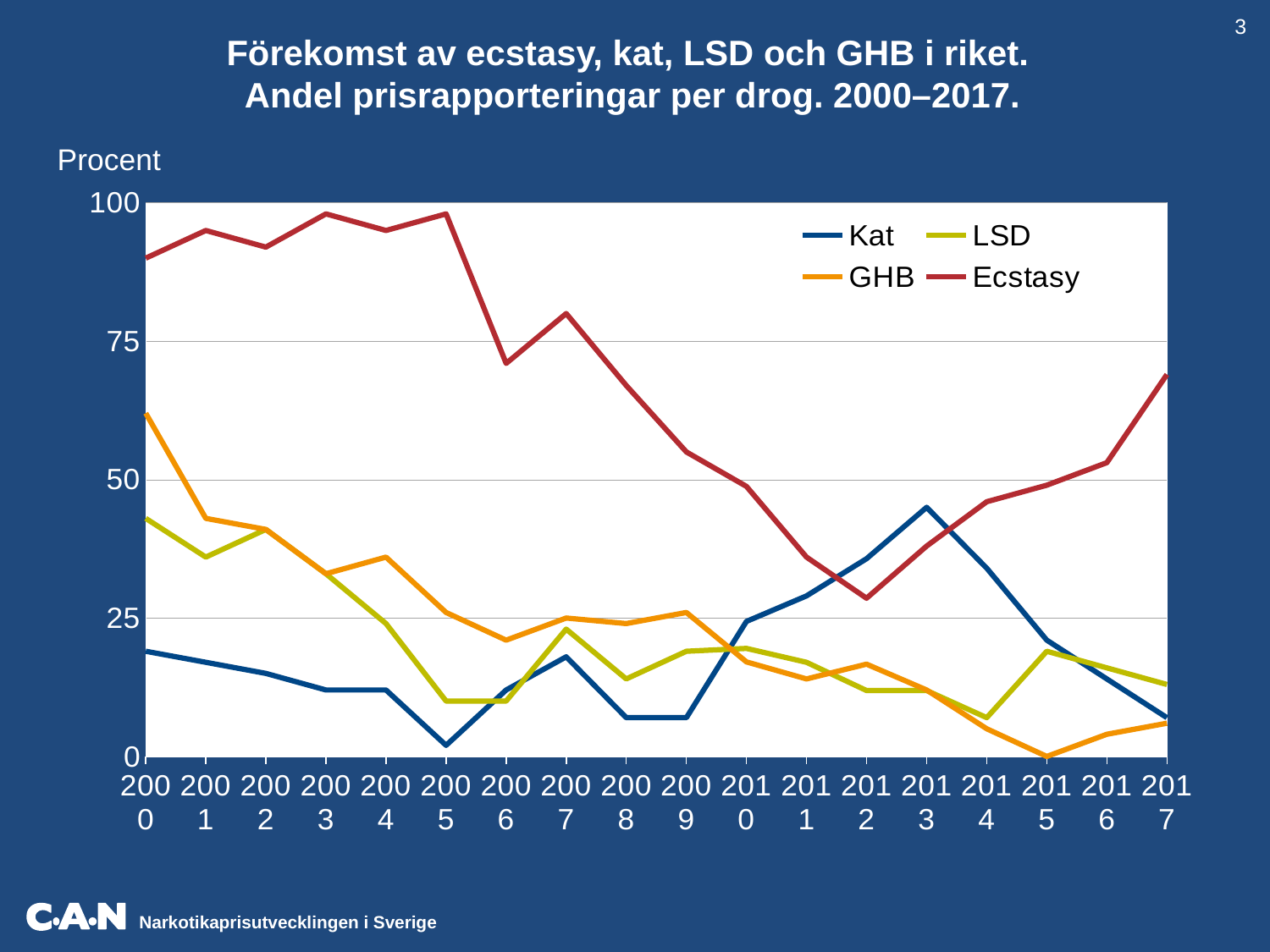
In which year does the Kat series reach its lowest value? 2005 Is the value for Ecstasy in 2017 greater or less than 50? greater How many years are shown along the x axis? 18 How many series does the legend list? 4 In which year does the Kat series reach its highest value? 2013 What kind of chart is shown on the slide? Line chart Which series has the highest value in 2000? Ecstasy Does the Ecstasy series rise or fall from 2005 to 2012? Fall Is the value for Kat in 2005 greater or less than 25? less In 2015, which is larger, the value for LSD or the value for GHB? LSD Is the value for Ecstasy in 2000 greater or less than 75? greater